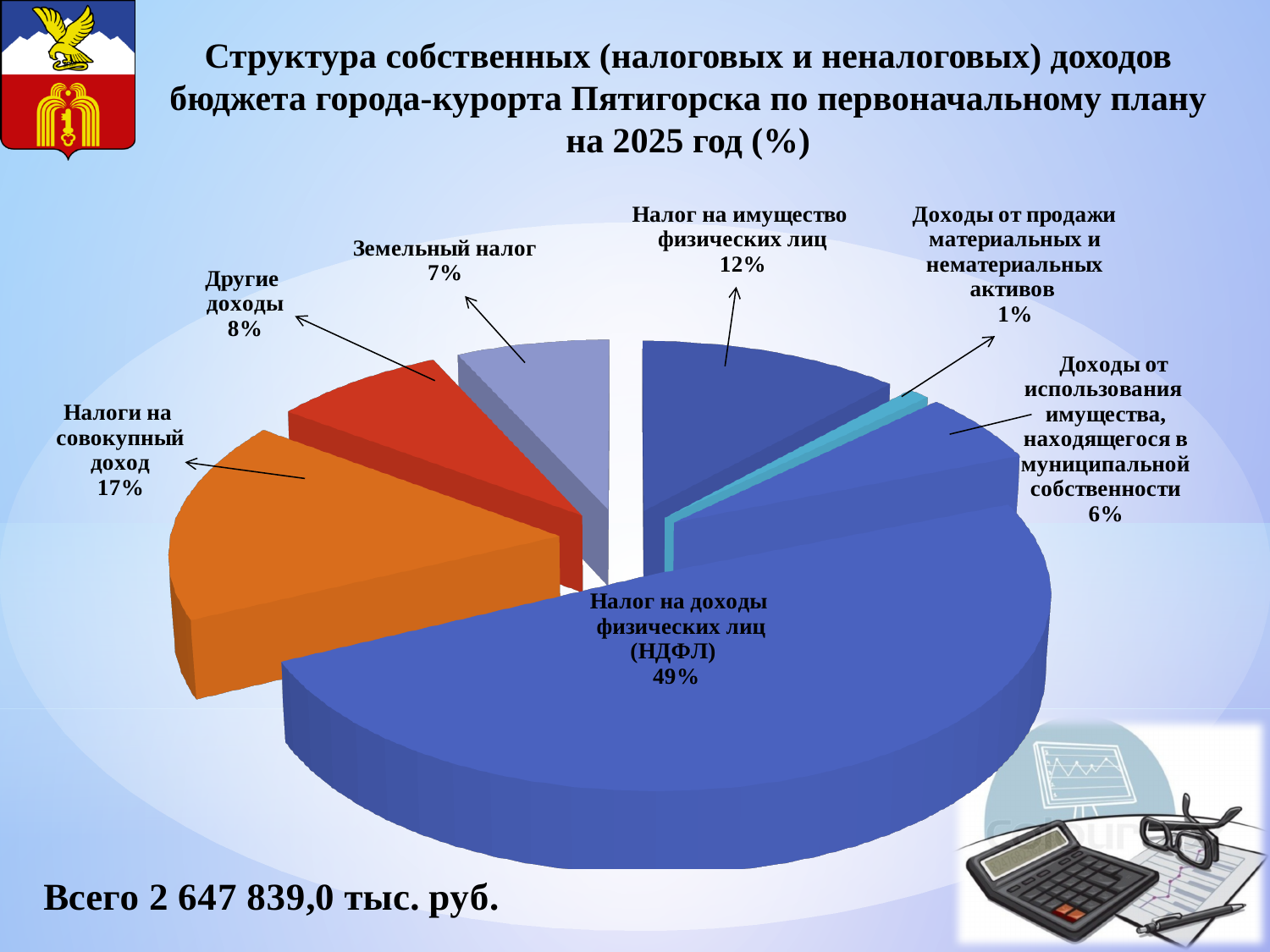
Which category has the largest slice of the pie? Налог на доходы физических лиц (НДФЛ) What is the value shown for Доходы от использования имущества, находящегося в муниципальной собственности? 6% What share of the pie does Налог на доходы физических лиц (НДФЛ) account for? 49% What kind of chart is shown on the slide? Pie chart What is the value shown for Налог на имущество физических лиц? 12% Which category has the smallest slice of the pie? Доходы от продажи материальных и нематериальных активов What is the value shown for Налоги на совокупный доход? 17% What is the value shown for Земельный налог? 7% What is the difference in percentage points between Налоги на совокупный доход and Другие доходы? 9 What total amount is stated at the bottom of the slide? 2 647 839,0 тыс. руб. Which is larger: Земельный налог or Налог на имущество физических лиц? Налог на имущество физических лиц How many slices does the pie chart have? 7